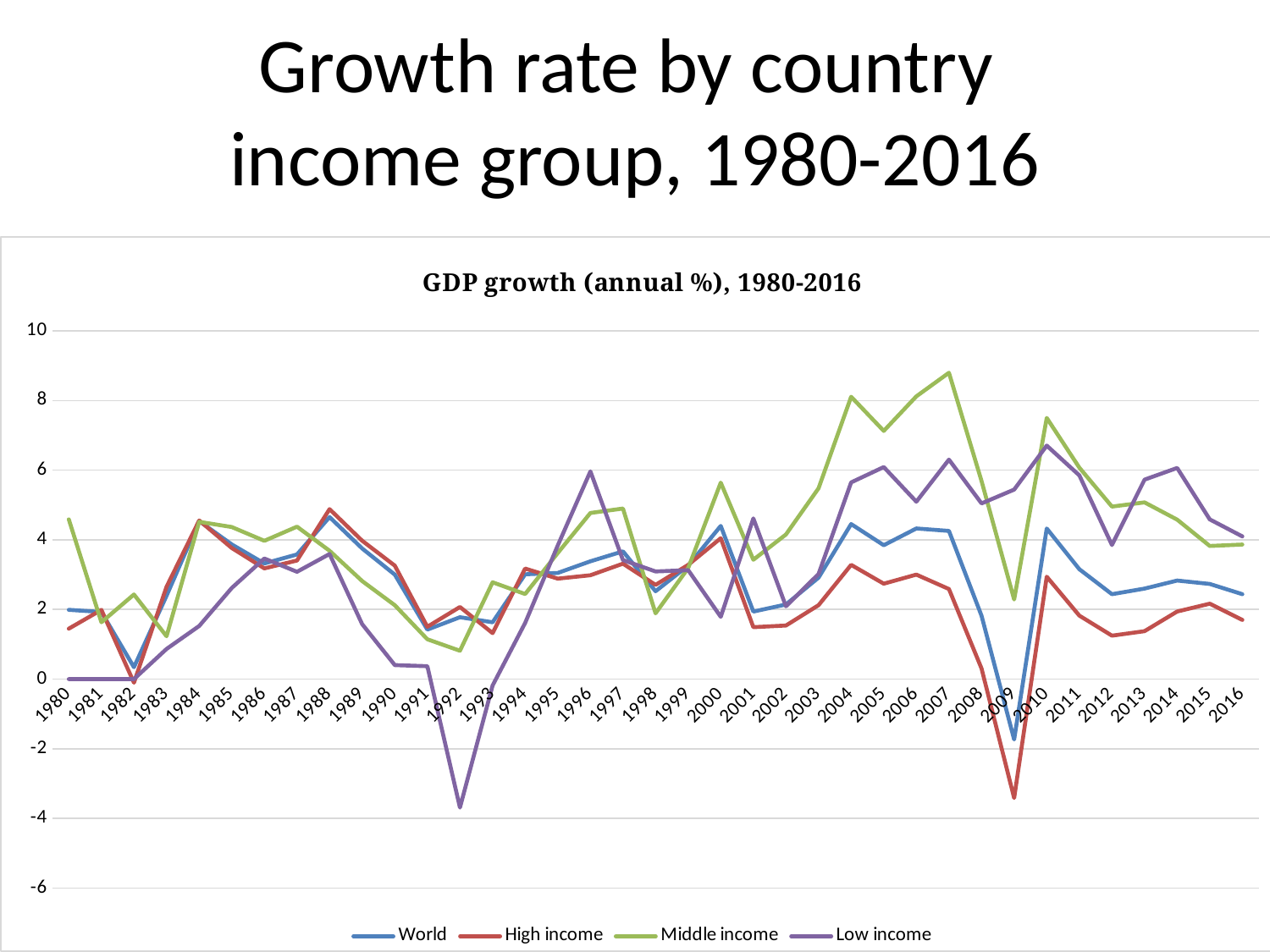
Does the High income series rise or fall from 2010 to 2012? fall How many years are plotted along the x axis? 37 Is the value for World in 2009 greater or less than 0? less Which series reaches the highest value anywhere on the chart? Middle income Is the value for Low income in 1992 greater or less than -2? less Is the value for Middle income in 2007 greater or less than 8? greater What is the title printed inside the chart area? GDP growth (annual %), 1980-2016 Which series has the lowest value in 2009? High income In 1992, which is higher: Middle income or Low income? Middle income In 2009, which is higher: World or High income? World How many series does the legend list? 4 What kind of chart is shown on the slide? line chart